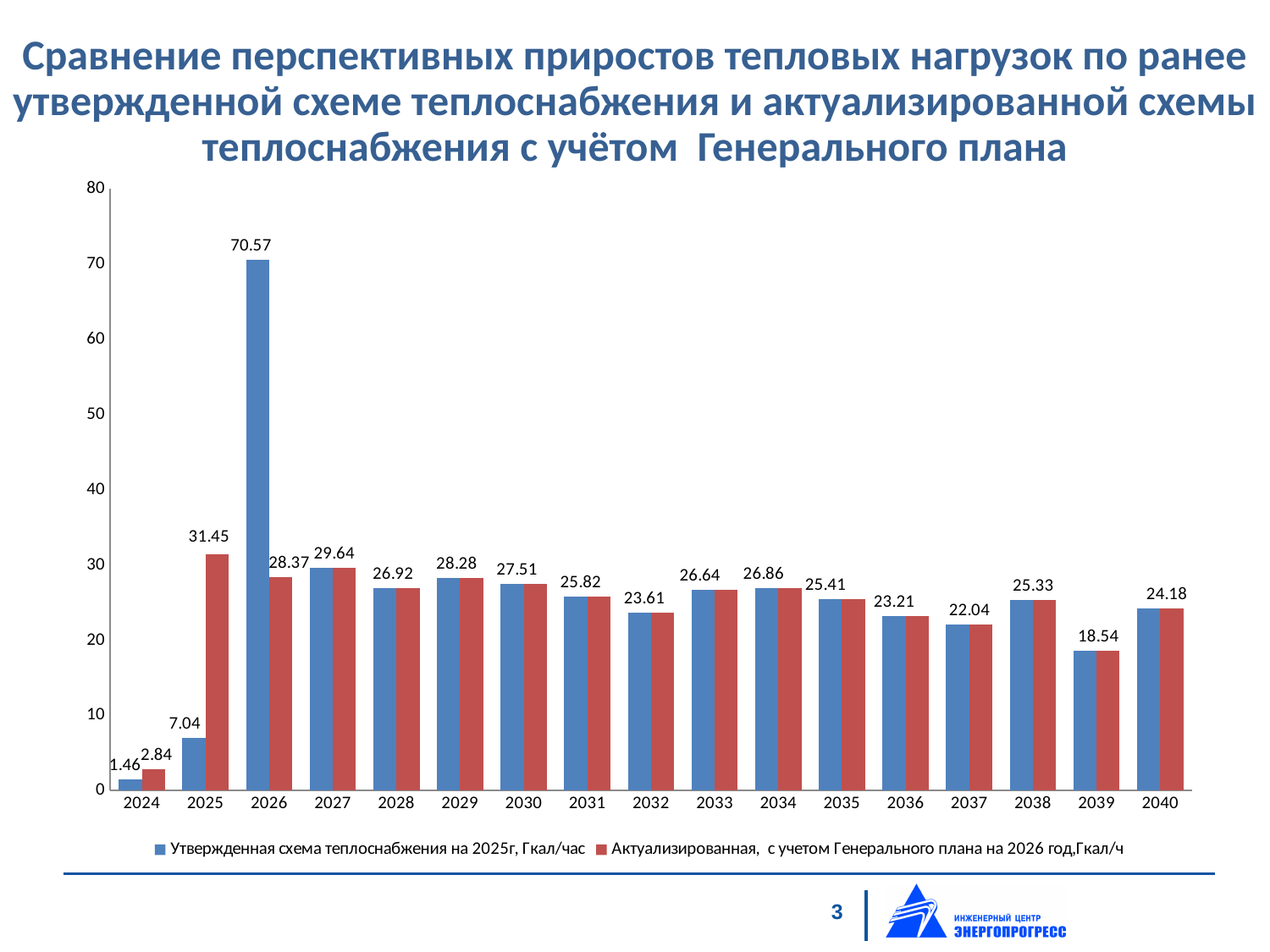
What is the value of the blue series (Утвержденная схема теплоснабжения на 2025г) for 2024? 1.46 In which year does the blue series (Утвержденная схема теплоснабжения на 2025г) reach its highest value? 2026 Is the blue bar for 2026 greater or less than 60? greater What is the difference between the red and blue values for 2025? 24.41 What is the value of the blue series (Утвержденная схема теплоснабжения на 2025г) for 2026? 70.57 For 2025, which series has the larger value: the blue (Утвержденная схема) or the red (Актуализированная)? Red (Актуализированная) What is the difference between the blue and red values for 2026? 42.20 How many years are shown on the x axis? 17 What value is labelled for the year 2039? 18.54 What is the value of the red series (Актуализированная, с учетом Генерального плана) for 2025? 31.45 How many series does the legend list? 2 In which year does the red series (Актуализированная, с учетом Генерального плана) have its lowest value? 2024